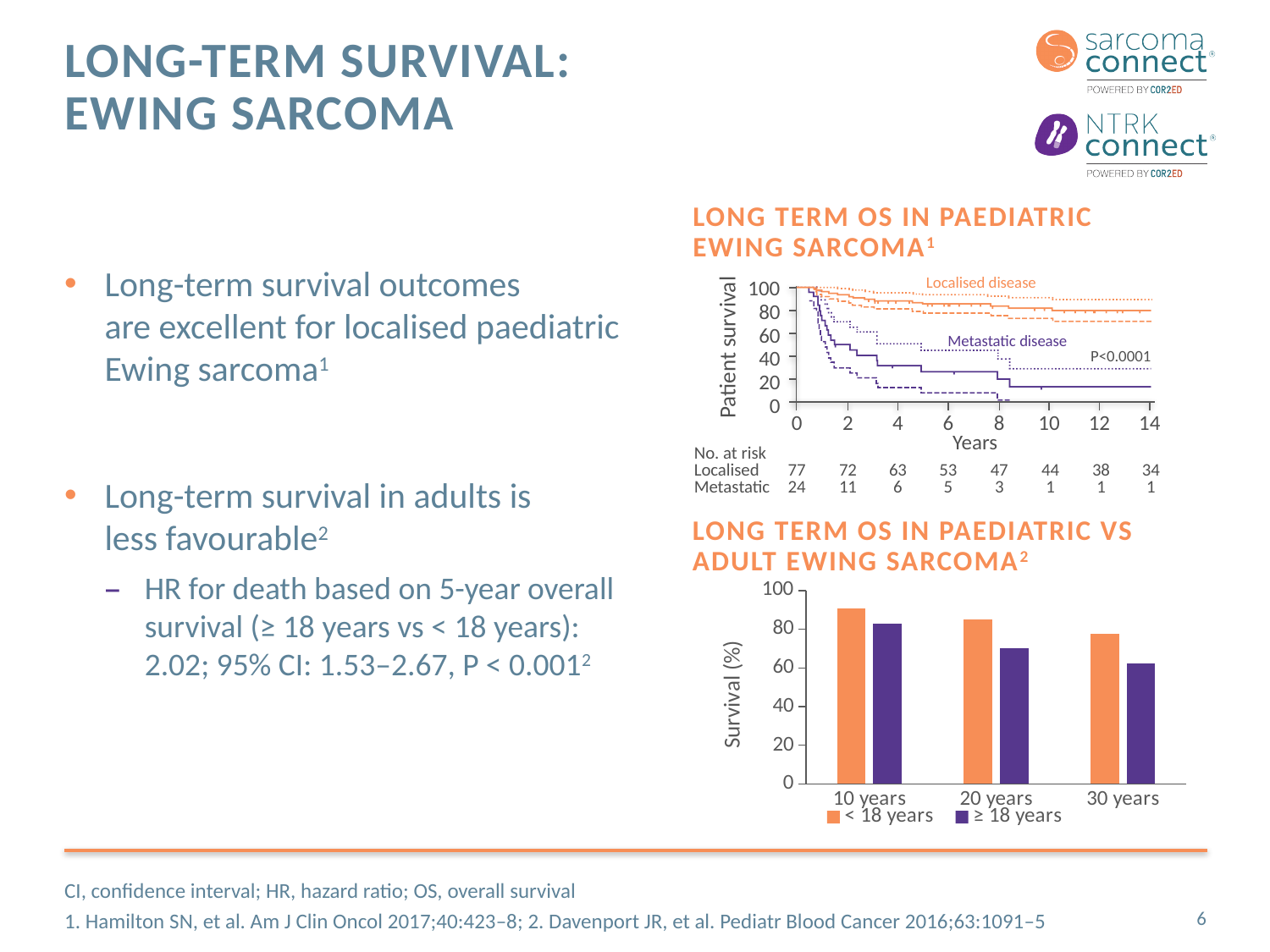
What kind of chart is the 'Long term OS in paediatric vs adult Ewing sarcoma' chart at the bottom right? Bar chart What P value is shown on the 'Long term OS in paediatric Ewing sarcoma' chart? P<0.0001 In the 'Long term OS in paediatric vs adult Ewing sarcoma' chart, is the survival value for < 18 years at 10 years greater or less than 80? greater In the 'Long term OS in paediatric Ewing sarcoma' chart, how many localised patients were at risk at 0 years? 77 In the 'Long term OS in paediatric vs adult Ewing sarcoma' chart, is the survival value for ≥ 18 years at 30 years greater or less than 80? less In the 'Long term OS in paediatric vs adult Ewing sarcoma' chart, is the survival value for ≥ 18 years at 20 years greater or less than 60? greater In the 'Long term OS in paediatric vs adult Ewing sarcoma' chart, do the survival values for < 18 years rise or fall from 10 years to 30 years? Fall How many time-point categories are shown on the x axis of the 'Long term OS in paediatric vs adult Ewing sarcoma' chart? 3 In the 'Long term OS in paediatric vs adult Ewing sarcoma' chart, which series is shown in purple? ≥ 18 years In the 'Long term OS in paediatric vs adult Ewing sarcoma' chart, which group has the higher survival at 20 years, < 18 years or ≥ 18 years? < 18 years In the 'Long term OS in paediatric Ewing sarcoma' chart, how many metastatic patients were at risk at 4 years? 6 How many series does the legend of the 'Long term OS in paediatric vs adult Ewing sarcoma' chart list? 2